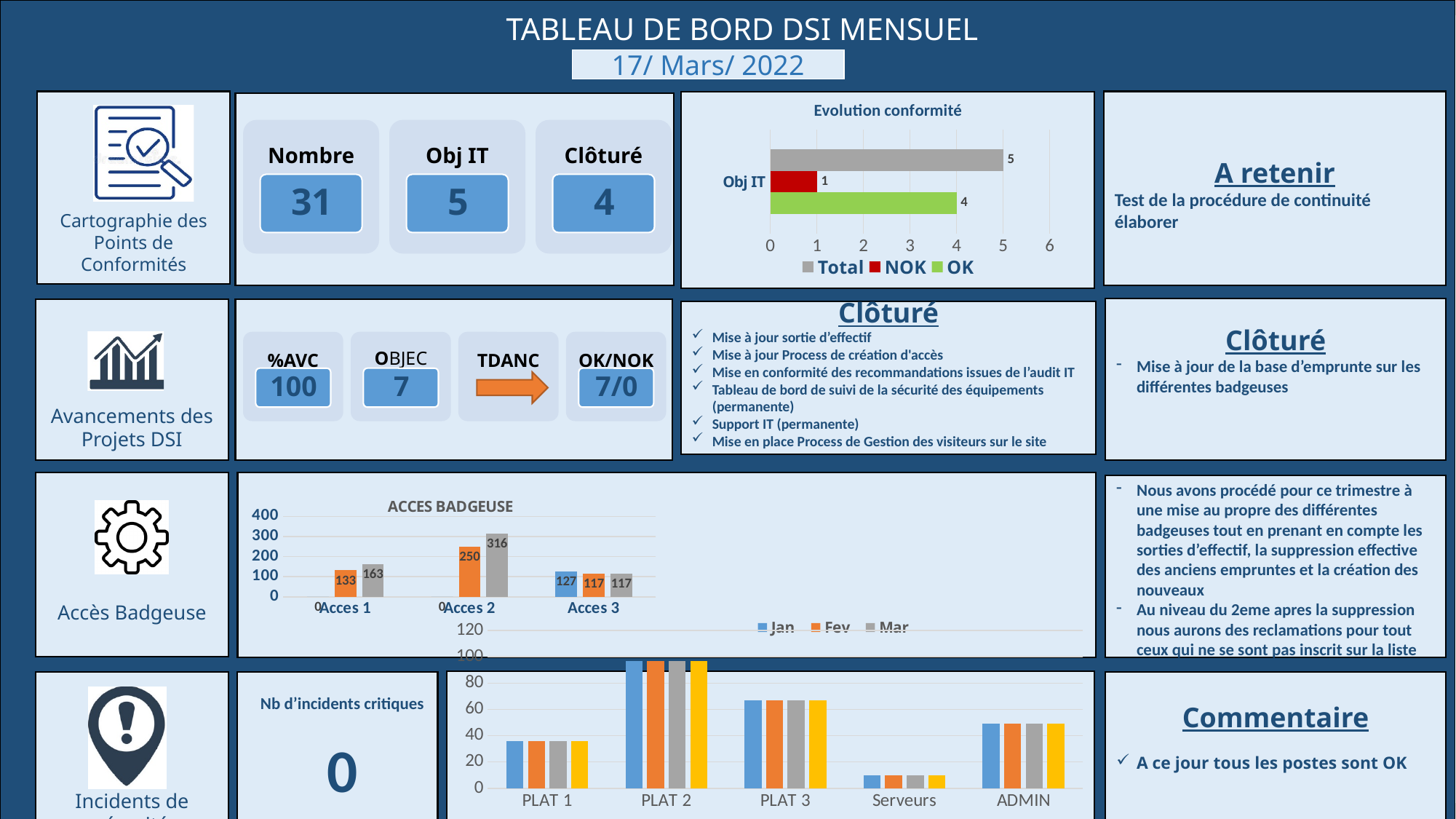
In the 'Evolution conformité' chart, how many series does the legend list? 3 In the 'ACCES BADGEUSE' chart, what is the Jan value for Acces 3? 127 In the 'Evolution conformité' chart, what is the difference between the Total and OK values for Obj IT? 1 In the 'ACCES BADGEUSE' chart, how many categories are shown on the x axis? 3 In the 'ACCES BADGEUSE' chart, what is the Mar value for Acces 2? 316 In the bottom chart with categories PLAT 1 to ADMIN, is the value of the first bar for Serveurs greater or less than 20? less In the 'ACCES BADGEUSE' chart, which category has the highest Mar value? Acces 2 In the 'ACCES BADGEUSE' chart, what is the difference between the Mar and Fev values for Acces 2? 66 In the 'Evolution conformité' chart, what is the value of the NOK series for Obj IT? 1 In the 'Evolution conformité' chart, what is the value of the OK series for Obj IT? 4 In the 'Evolution conformité' chart, what is the value of the Total series for Obj IT? 5 In the 'ACCES BADGEUSE' chart, what is the Fev value for Acces 1? 133